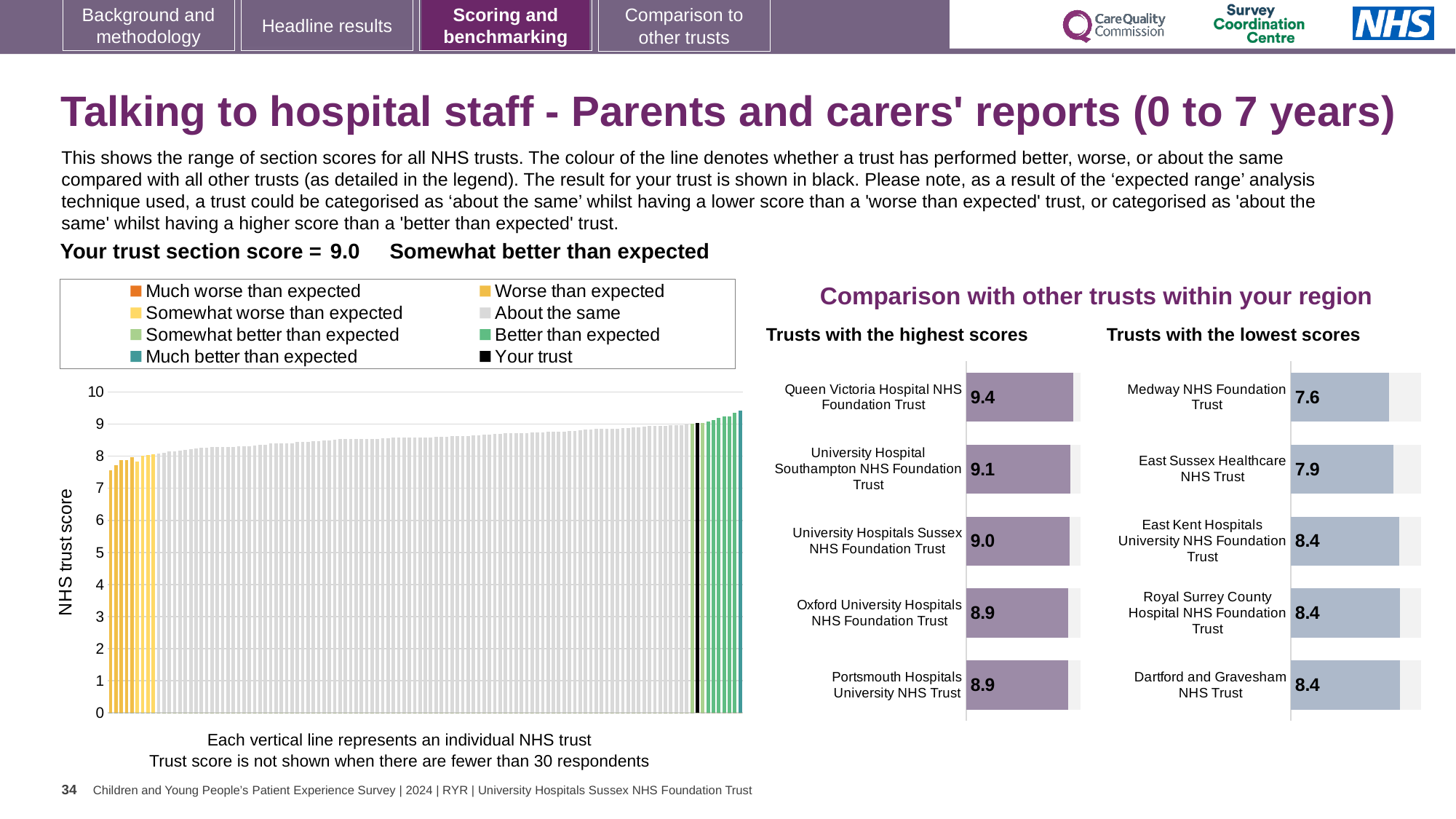
In the 'Trusts with the lowest scores' chart, what is the score for Medway NHS Foundation Trust? 7.6 How many entries does the legend of the NHS trust score chart on the left list? 8 In the NHS trust score chart on the left, is the value of the black bar (your trust) greater or less than 8? greater In the 'Trusts with the highest scores' chart, what is the difference between the scores of Queen Victoria Hospital NHS Foundation Trust and University Hospital Southampton NHS Foundation Trust? 0.3 In the 'Trusts with the lowest scores' chart, which trust has the lowest score? Medway NHS Foundation Trust How many trusts are shown in the 'Trusts with the lowest scores' chart? 5 In the 'Trusts with the highest scores' chart, what is the score for Queen Victoria Hospital NHS Foundation Trust? 9.4 In the 'Trusts with the highest scores' chart, which has the larger score: University Hospital Southampton NHS Foundation Trust or Oxford University Hospitals NHS Foundation Trust? University Hospital Southampton NHS Foundation Trust In the NHS trust score chart on the left, do the values rise or fall from left to right? Rise What kind of chart is the 'Trusts with the highest scores' chart? Bar chart In the 'Trusts with the highest scores' chart, which trust has the highest score? Queen Victoria Hospital NHS Foundation Trust In the 'Trusts with the lowest scores' chart, what is the difference between the scores of Dartford and Gravesham NHS Trust and Medway NHS Foundation Trust? 0.8